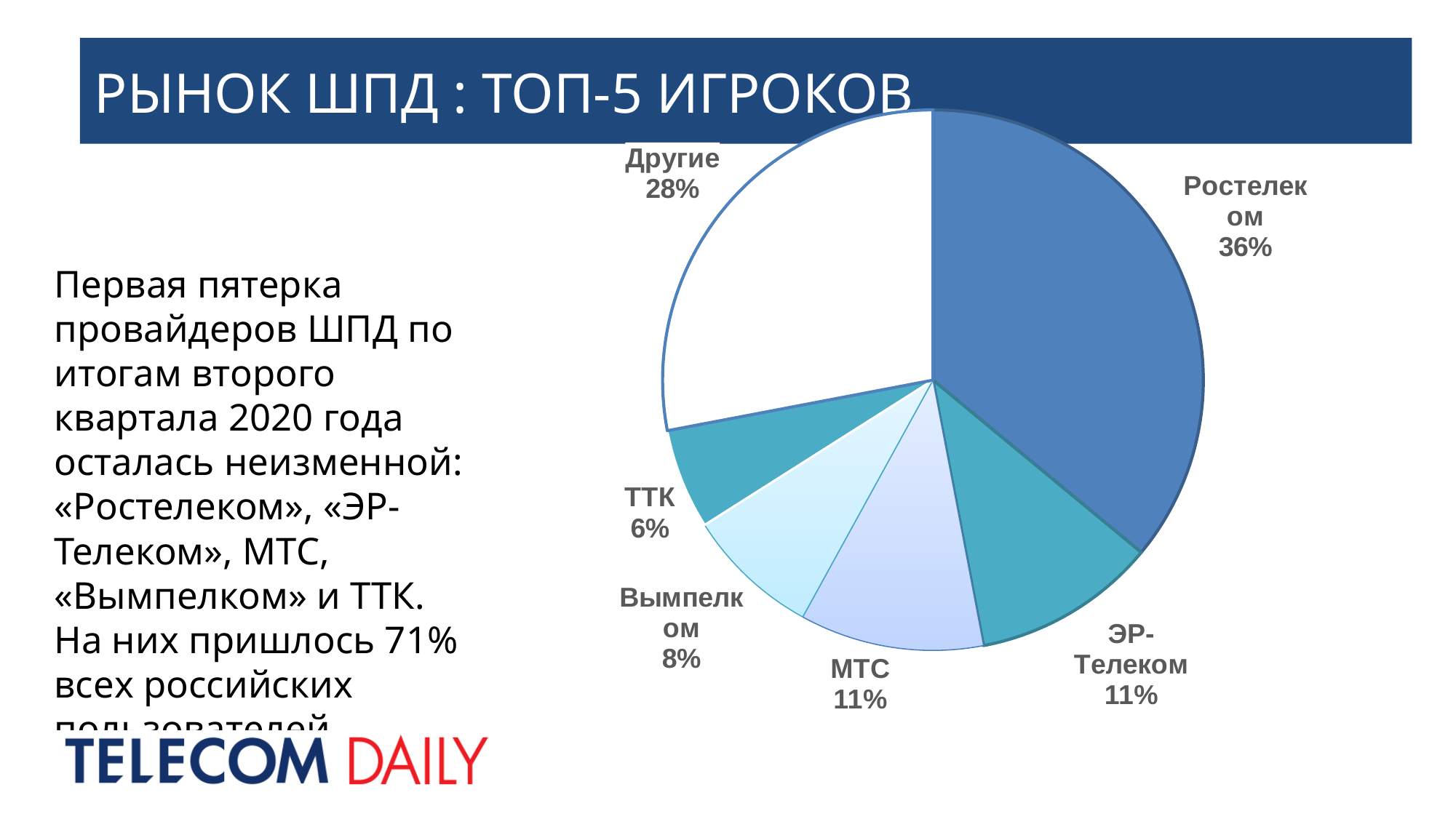
What is the title of the slide containing the chart? РЫНОК ШПД : ТОП-5 ИГРОКОВ How many slices does the pie chart have? 6 Which slice of the pie is the smallest? ТТК What is the difference between the shares of Ростелеком and Другие? 8% Which is larger, the share of Вымпелком or the share of ТТК? Вымпелком Which slice of the pie is the largest? Ростелеком What is the difference between the shares of Вымпелком and ТТК? 2% What is the value shown for Другие? 28% What kind of chart is shown on the slide? Pie chart What share of the pie does Ростелеком hold? 36% What is the value shown for ТТК? 6% What is the value shown for Вымпелком? 8%